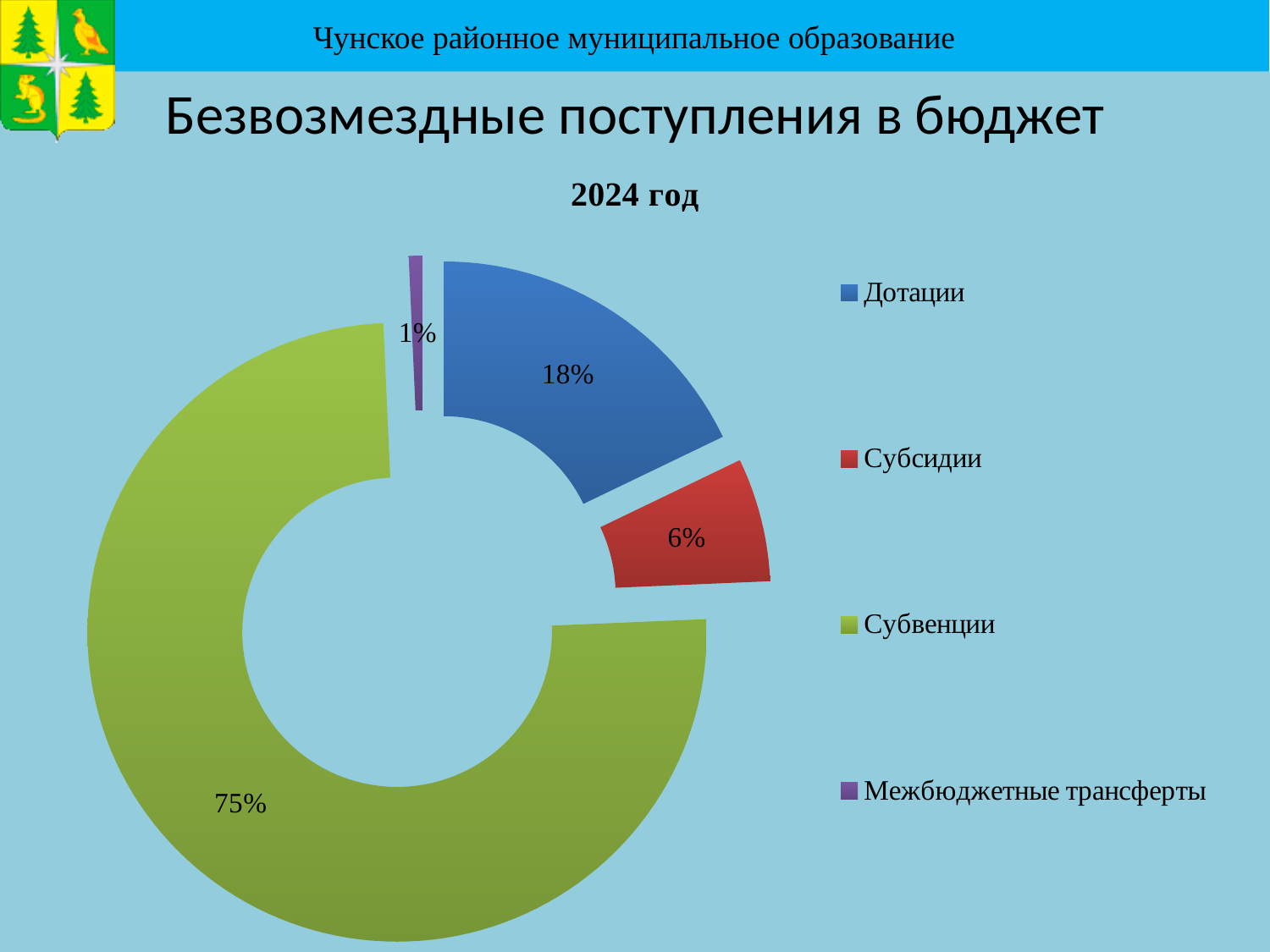
Which is larger, Дотации or Субсидии? Дотации Which category has the smallest share? Межбюджетные трансферты What kind of chart is shown on the slide? Doughnut (pie) chart What is the difference in percentage points between Дотации and Субсидии? 12 What share of the chart does Субвенции account for? 75% What is the value shown for Субсидии? 6% What is the value shown for Межбюджетные трансферты? 1% What colour is the Субвенции segment? Green Which category has the largest share? Субвенции What is the title of the chart? 2024 год How many categories does the chart show? 4 What is the value shown for Дотации? 18%